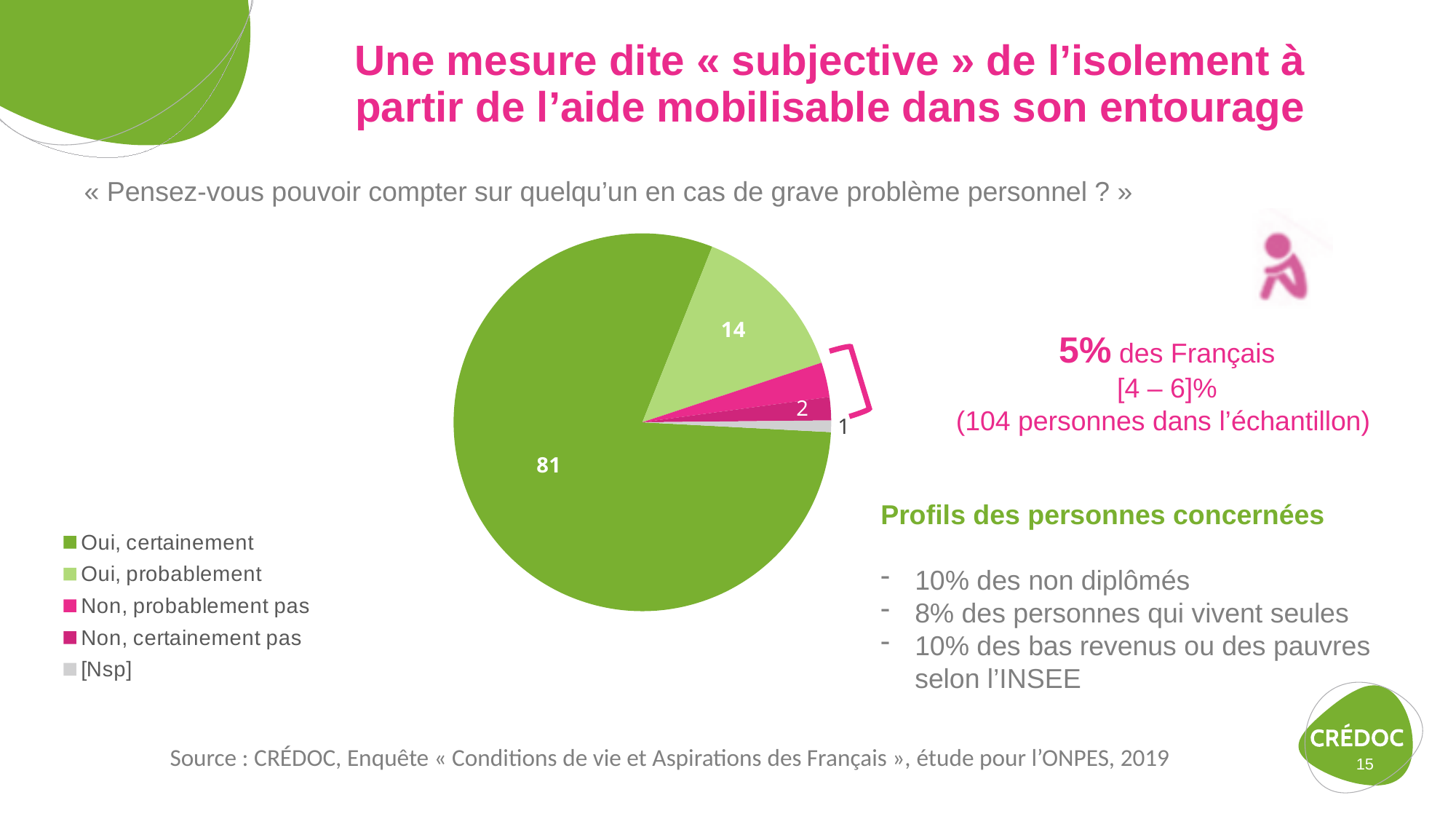
What is the difference between the values for "Oui, certainement" and "Oui, probablement"? 67 What colour is the slice for "Oui, certainement" in the pie chart? green What is the value shown for "Oui, probablement" in the pie chart? 14 What kind of chart is shown on the slide? pie chart Which legend entry is listed last in the pie chart's legend? [Nsp] Which is larger: the value for "Oui, probablement" or the value for "Non, probablement pas"? Oui, probablement What is the value shown for "Oui, certainement" in the pie chart? 81 How many categories does the legend of the pie chart list? 5 Which category has the largest slice of the pie chart? Oui, certainement